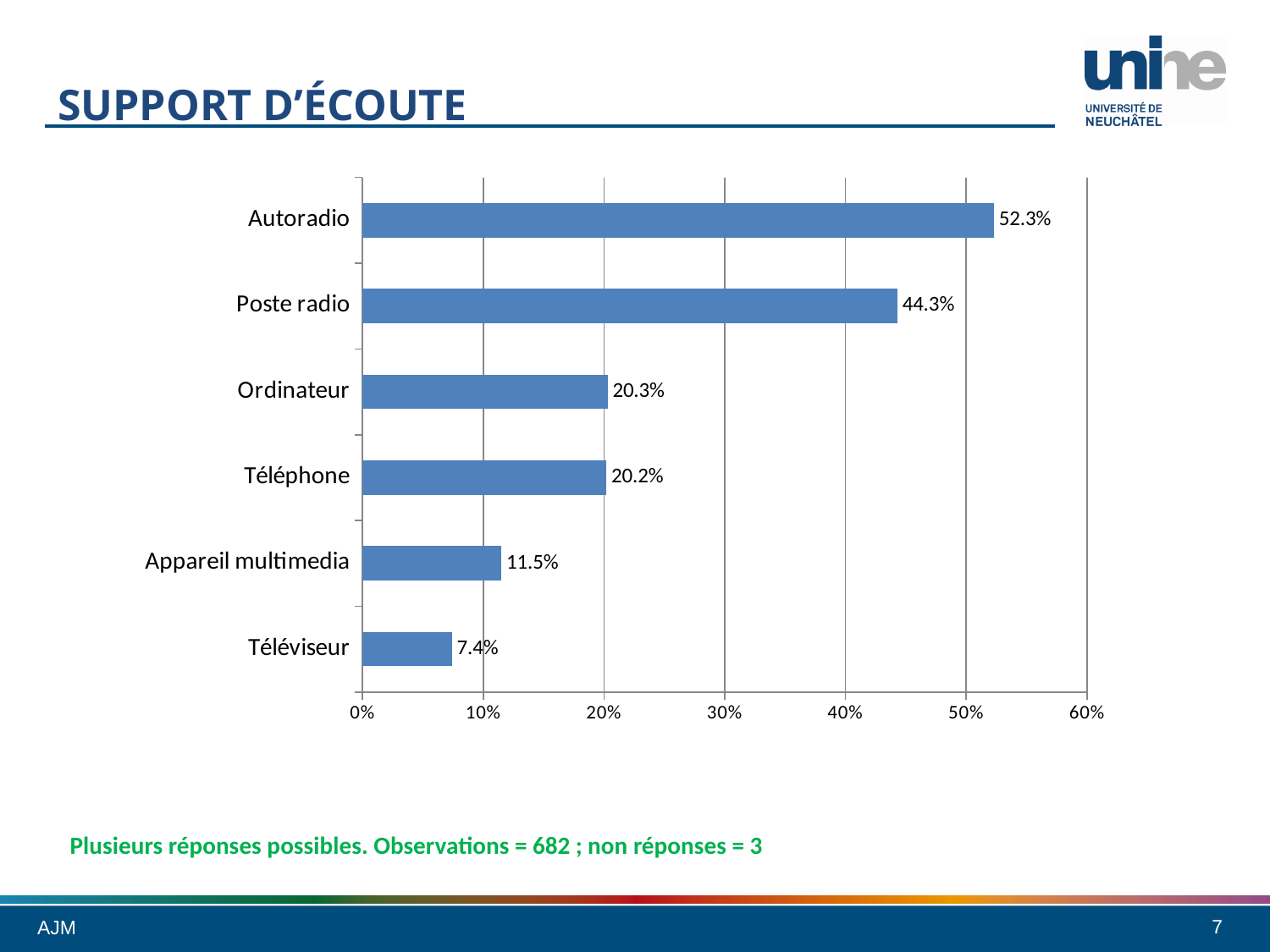
What is the value for Appareil multimedia? 11.5% Which category has the highest value? Autoradio Which is larger, the value for Poste radio or the value for Appareil multimedia? Poste radio How many categories are shown in the chart? 6 What is the value for Autoradio? 52.3% Is the value for Autoradio greater or less than 50%? greater What is the difference between the values for Autoradio and Poste radio? 8.0% What is the value for Téléviseur? 7.4% What is the value for Poste radio? 44.3% What kind of chart is shown on the slide? bar chart What is the difference between the values for Ordinateur and Téléphone? 0.1% Which category has the lowest value? Téléviseur